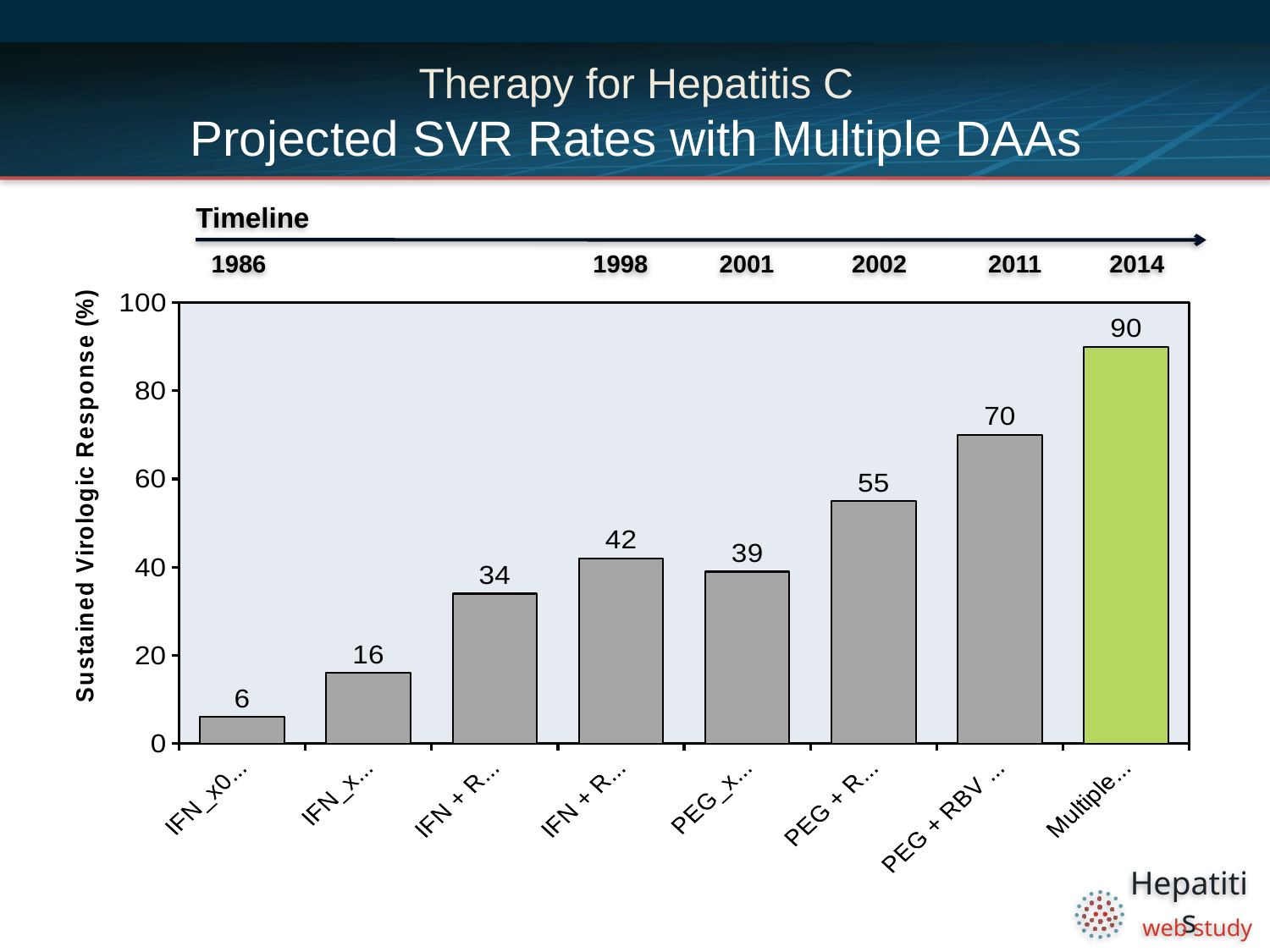
What is the value of the first (leftmost) bar in the chart? 6 What type of chart is shown on the slide? bar chart How many bars are plotted in the chart? 8 What is the lowest value shown in the chart? 6 What is the label of the y-axis? Sustained Virologic Response (%) What is the value of the seventh bar from the left? 70 Is the value of the sixth bar from the left greater or less than 60? less Which bar has the highest value in the chart? the last (rightmost, green) bar What is the value of the last (rightmost, green) bar in the chart? 90 What is the difference between the rightmost bar (90) and the seventh bar (70)? 20 What is the value of the second bar from the left? 16 Which is larger, the fourth bar from the left or the fifth bar from the left? the fourth bar (42)